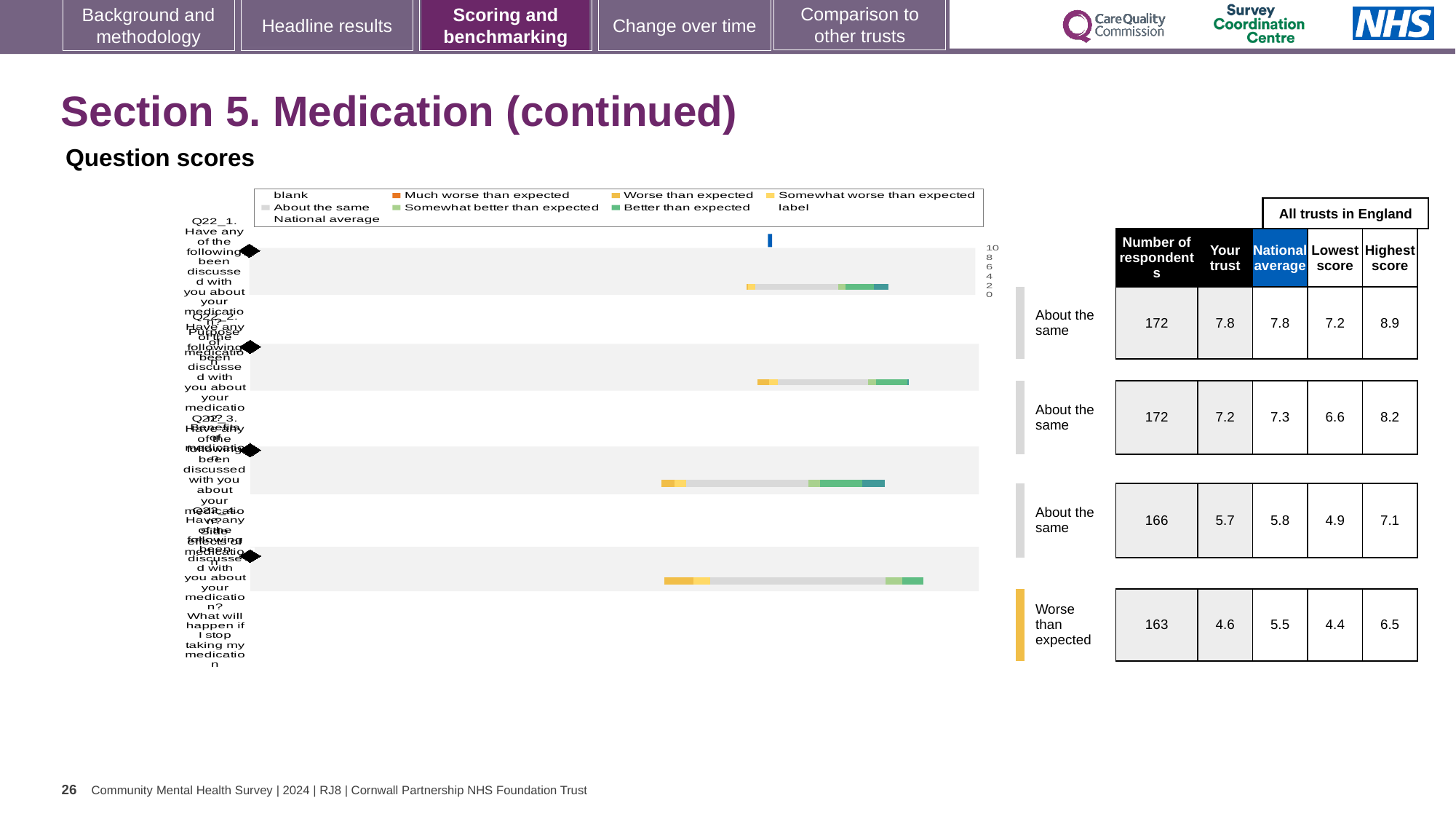
What is the highest value shown on the chart's numeric axis? 10 In the table beside the chart, how many respondents are recorded for the third question row? 166 In the table beside the chart, what is the national average for the row labelled 'Worse than expected'? 5.5 Which legend entry is shown in orange? Much worse than expected In the table beside the chart, is the 'Your trust' score for the second question row larger or smaller than its national average? smaller Which question row has the lowest 'Your trust' score in the table beside the chart? the fourth row (Worse than expected) What kind of chart is shown under 'Question scores'? bar chart How many entries does the chart legend list? 9 In the table beside the chart, what is the 'Your trust' score for the first question row? 7.8 In the table beside the chart, what is the 'Your trust' score for the row labelled 'Worse than expected'? 4.6 How many horizontal bars (question rows) does the chart contain? 4 In the table beside the chart, what is the difference between the national average and the 'Your trust' score for the row labelled 'Worse than expected'? 0.9